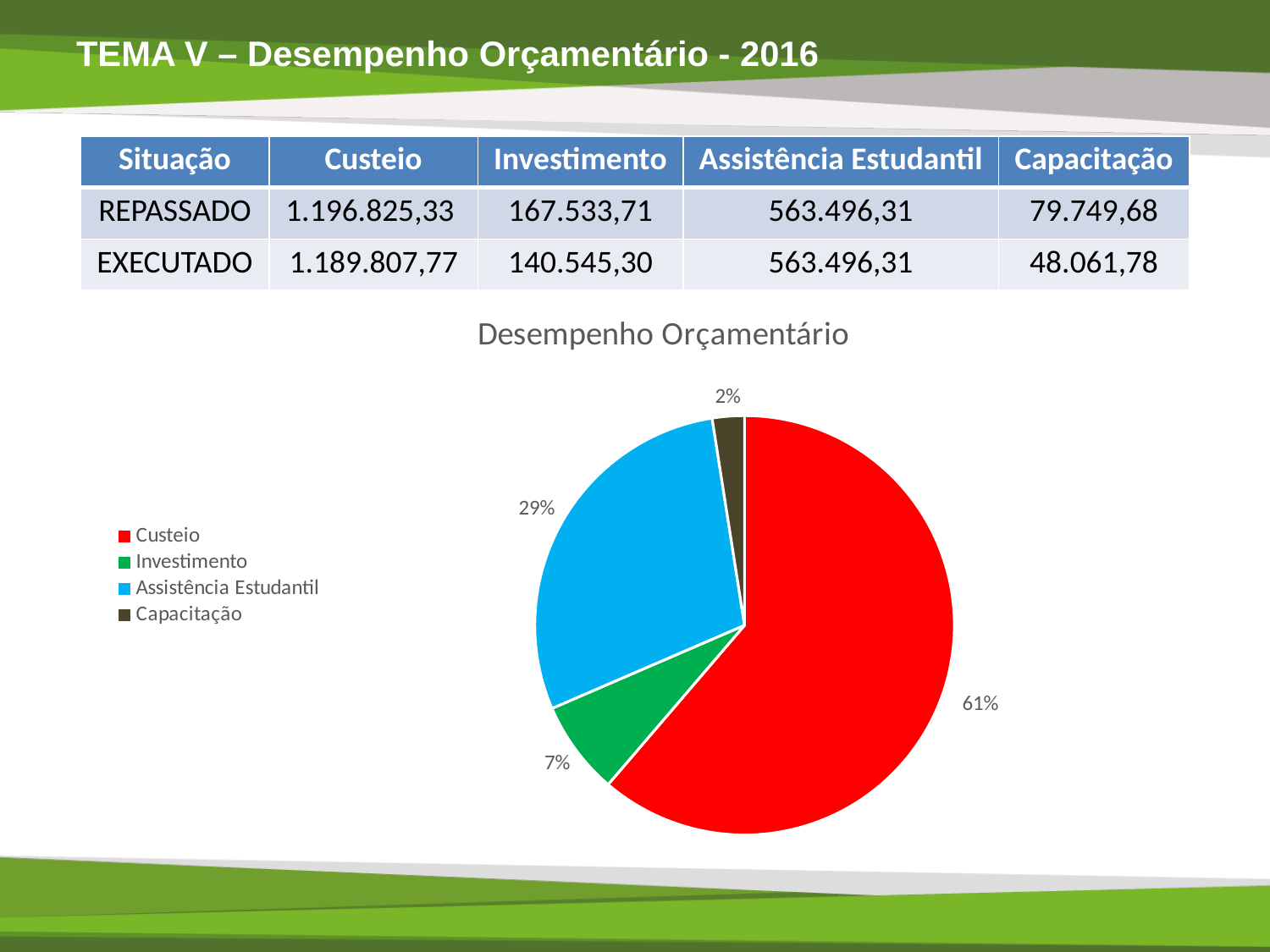
What share of the pie does Assistência Estudantil represent? 29% What share of the pie does Custeio represent? 61% Which category has the largest slice of the pie? Custeio What is the difference in percentage points between the Custeio slice and the Assistência Estudantil slice? 32% Which is larger in the pie chart, Investimento or Assistência Estudantil? Assistência Estudantil What share of the pie does Investimento represent? 7% How many categories does the pie chart show? 4 What is the title of the chart? Desempenho Orçamentário How many entries does the legend list? 4 What type of chart is shown under the title "Desempenho Orçamentário"? Pie chart Which category has the smallest slice of the pie? Capacitação